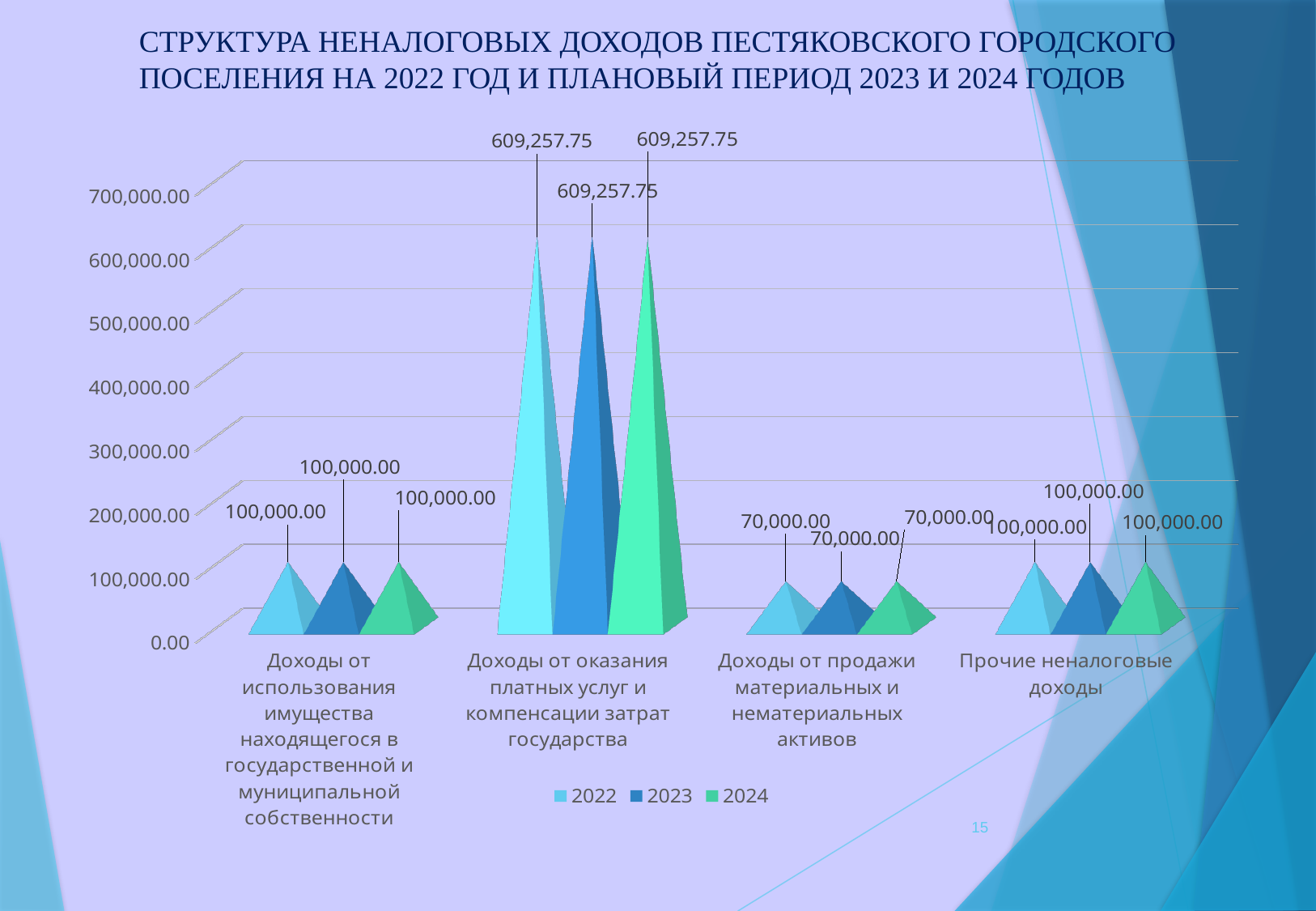
What is the difference between the 2022 value for "Доходы от оказания платных услуг и компенсации затрат государства" and the 2022 value for "Прочие неналоговые доходы"? 509,257.75 What is the value for 2022 for "Доходы от использования имущества находящегося в государственной и муниципальной собственности"? 100,000.00 How many series does the legend list? 3 What is the difference between the 2023 value for "Прочие неналоговые доходы" and the 2023 value for "Доходы от продажи материальных и нематериальных активов"? 30,000.00 What is the value for 2022 for "Доходы от оказания платных услуг и компенсации затрат государства"? 609,257.75 What is the value for 2023 for "Доходы от продажи материальных и нематериальных активов"? 70,000.00 What is the value for 2024 for "Прочие неналоговые доходы"? 100,000.00 What kind of chart is shown on the slide? Bar chart Which category has the highest value for 2023? Доходы от оказания платных услуг и компенсации затрат государства Which is larger: the 2024 value for "Доходы от использования имущества находящегося в государственной и муниципальной собственности" or the 2024 value for "Доходы от продажи материальных и нематериальных активов"? Доходы от использования имущества находящегося в государственной и муниципальной собственности How many categories are shown on the x axis? 4 Which category has the lowest value for 2024? Доходы от продажи материальных и нематериальных активов